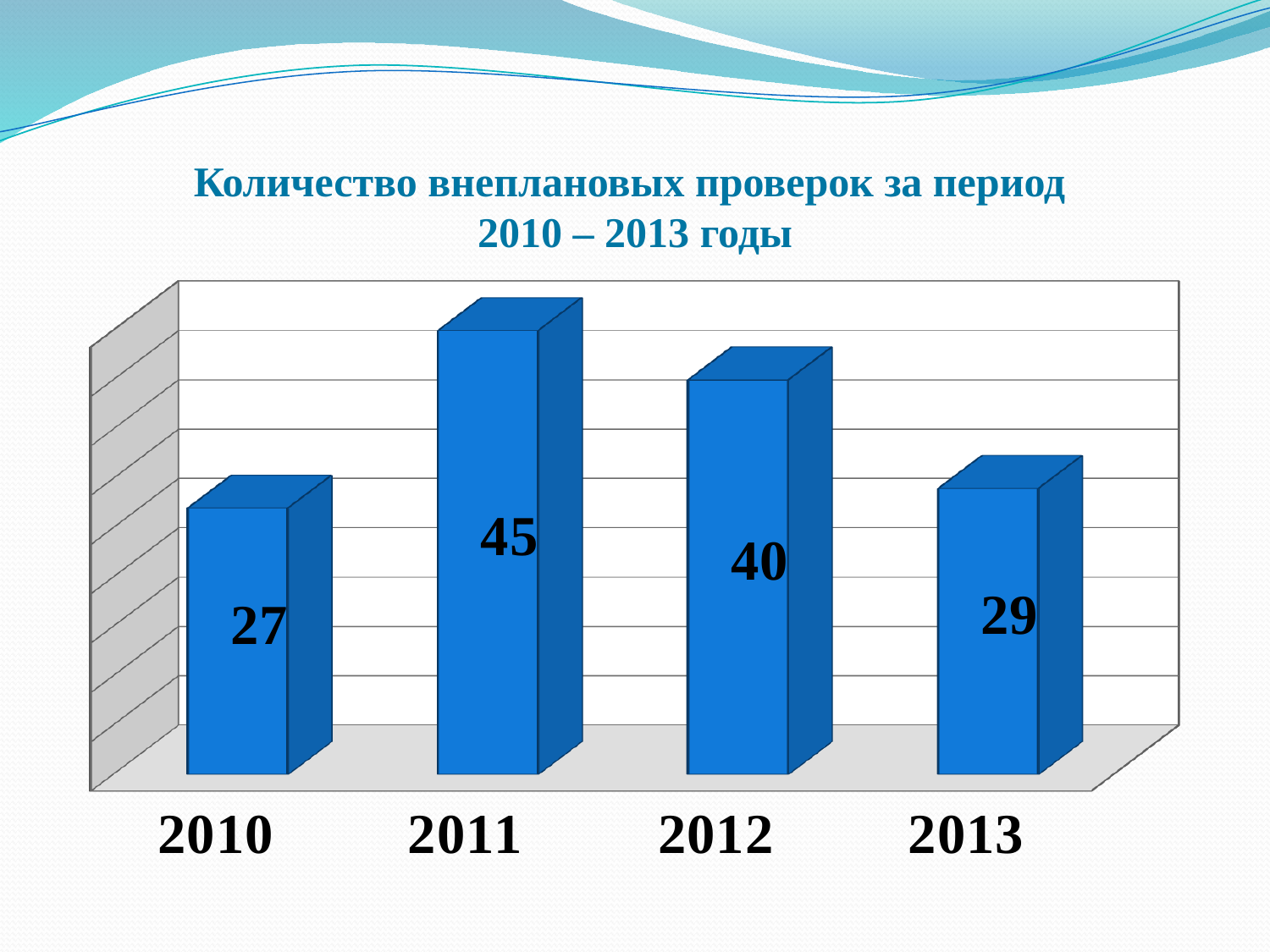
How many years are shown on the chart? 4 What is the value for 2012? 40 Which year has the highest value? 2011 Which is larger, the value for 2012 or the value for 2013? 2012 What is the difference between the values for 2011 and 2012? 5 What is the title of the chart? Количество внеплановых проверок за период 2010 – 2013 годы What kind of chart is shown on the slide? bar chart What is the difference between the values for 2011 and 2010? 18 Which year has the lowest value? 2010 What is the value for 2013? 29 What is the value for 2010? 27 What is the value for 2011? 45